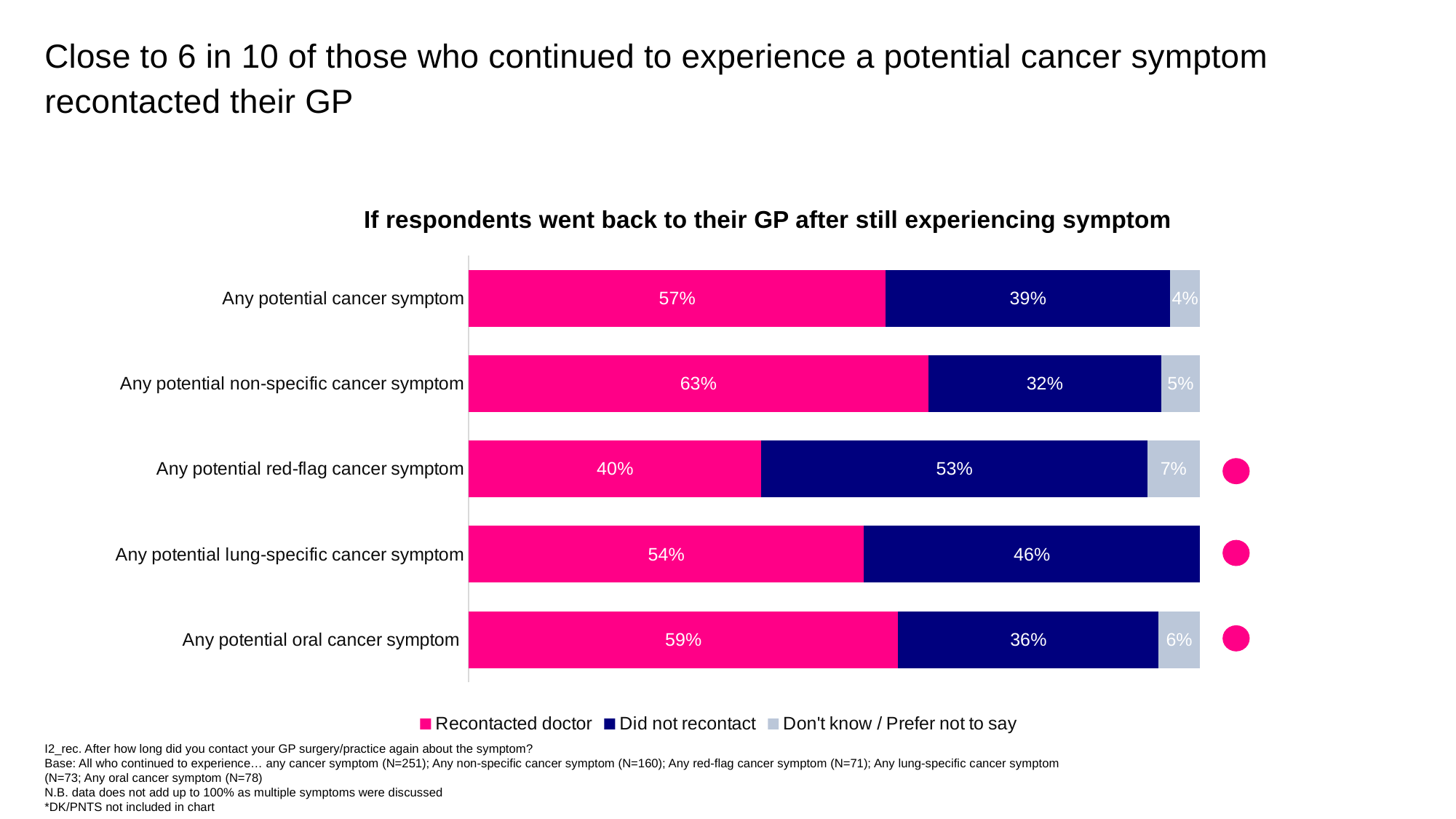
What is the title of the chart? If respondents went back to their GP after still experiencing symptom What is the difference between the 'Recontacted doctor' percentages for any potential non-specific cancer symptom and any potential red-flag cancer symptom? 23 percentage points How many series does the legend list? 3 Which symptom category has the highest share of respondents who recontacted their doctor? Any potential non-specific cancer symptom What is the 'Don't know / Prefer not to say' value for any potential oral cancer symptom? 6% How many symptom categories are shown in the chart? 5 Which symptom category has the lowest share of respondents who recontacted their doctor? Any potential red-flag cancer symptom What is the total of the stacked bar for any potential cancer symptom? 100% What percentage of respondents with any potential red-flag cancer symptom did not recontact their GP? 53% For any potential lung-specific cancer symptom, which is larger: the share who recontacted the doctor or the share who did not recontact? Recontacted doctor What percentage of respondents with any potential non-specific cancer symptom recontacted their doctor? 63% What type of chart is shown on the slide? Stacked bar chart